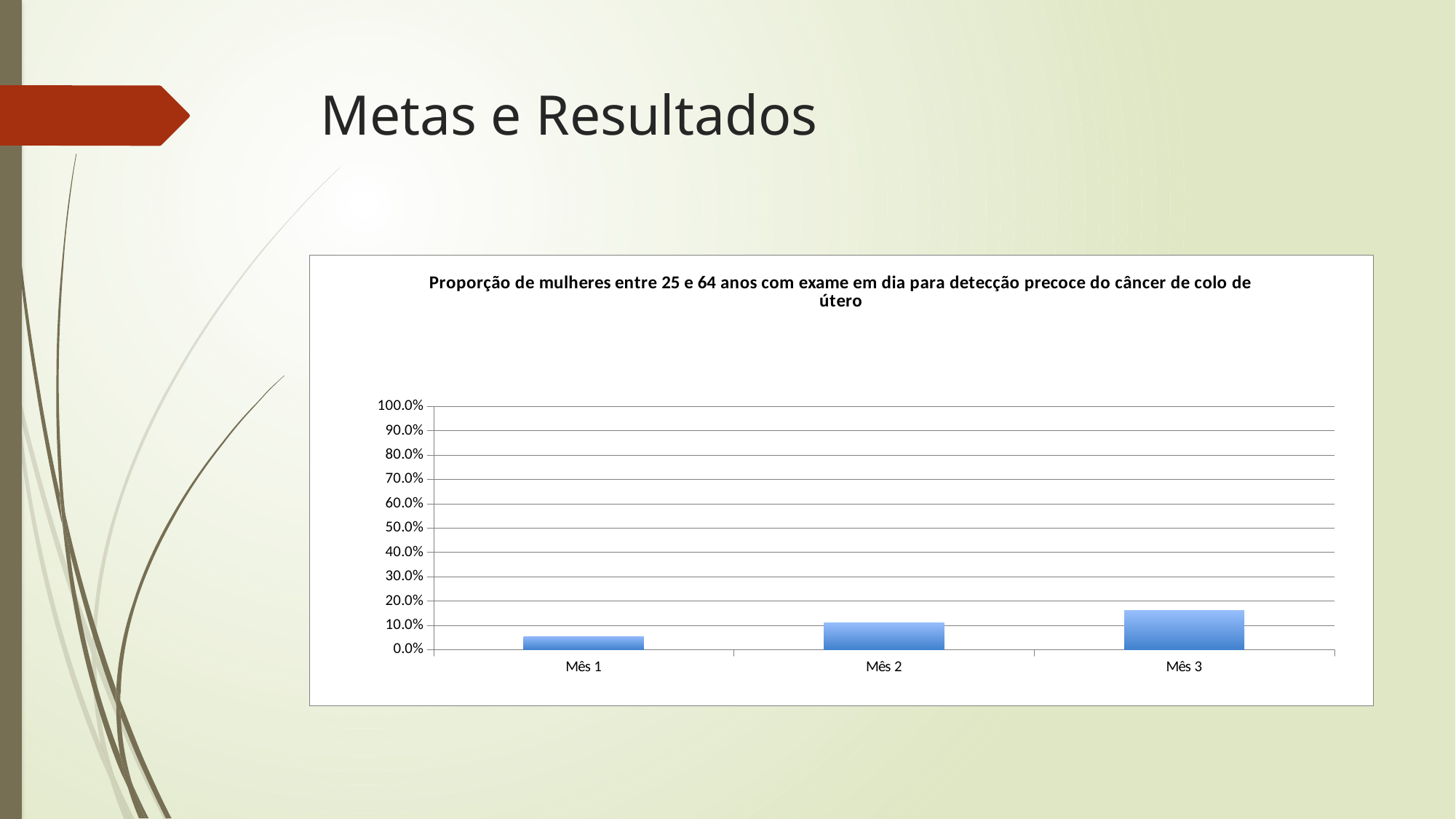
Which month has the lowest proportion on the chart? Mês 1 Is the value for Mês 2 greater or less than 20.0%? less Is the value for Mês 1 greater or less than 10.0%? less Which month has the highest proportion on the chart? Mês 3 What is the highest value shown on the vertical axis of the chart? 100.0% How many categories (months) are plotted on the chart? 3 What is the title of the chart? Proporção de mulheres entre 25 e 64 anos com exame em dia para detecção precoce do câncer de colo de útero Is the value for Mês 3 greater or less than 10.0%? greater Which is larger, the value for Mês 1 or the value for Mês 3? Mês 3 Do the values rise or fall from Mês 1 to Mês 3? rise What kind of chart is shown on the slide? bar chart